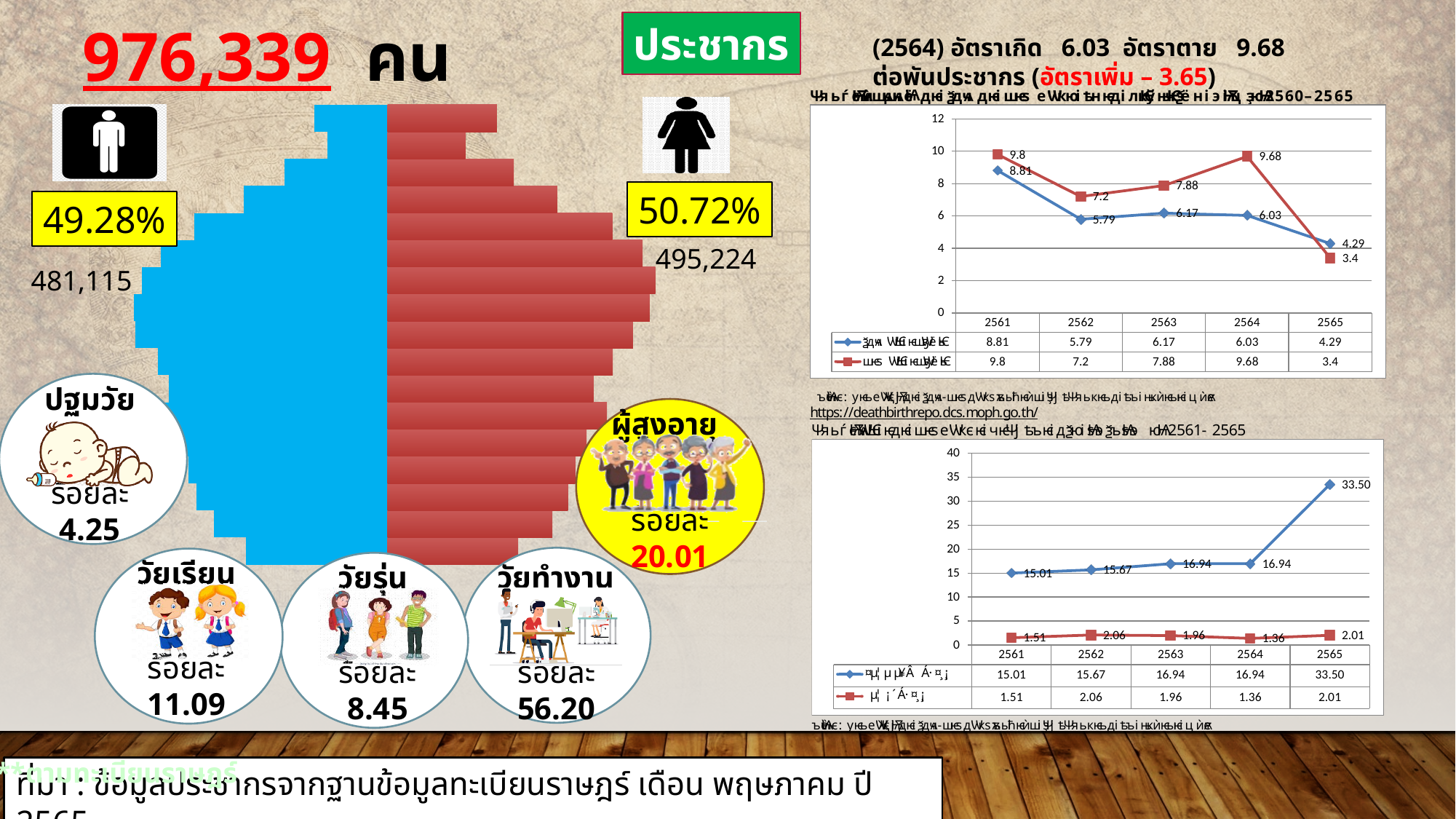
In the upper right line chart, which series has the larger value in 2565, blue or red? blue In the upper right line chart, in which year is the red series highest? 2561 In the upper right line chart, what is the value of the red series in 2562? 7.2 In the lower right line chart, in which year is the red series lowest? 2564 What kind of chart is the lower right chart? line chart In the lower right line chart, what is the value of the blue series in 2565? 33.50 How many years are plotted on the x axis of the upper right line chart? 5 In the upper right line chart, in which year is the blue series lowest? 2565 How many series does the legend of the lower right line chart list? 2 In the upper right line chart, what is the value of the blue series in 2564? 6.03 In the upper right line chart, what is the difference between the red and blue series values in 2564? 3.65 In the lower right line chart, does the blue series rise or fall from 2561 to 2565? rise